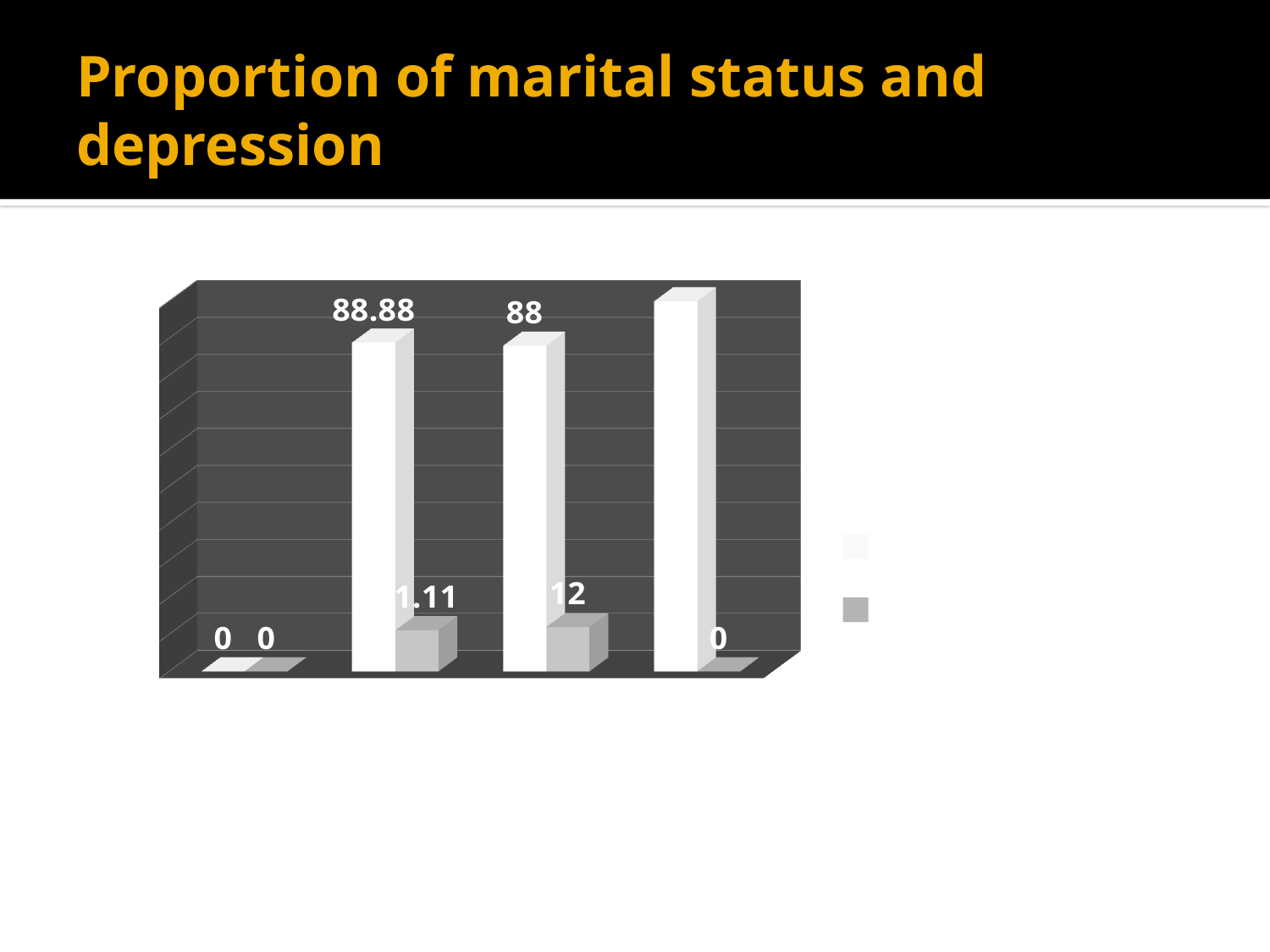
What values are labelled on the two bars in the first group from the left? 0 and 0 How many series does the chart's legend list? 2 What kind of chart is shown on the slide? bar chart What is the value labelled on the white bar in the second group from the left? 88.88 What is the value labelled on the grey bar in the third group from the left? 12 What is the value labelled on the white bar in the third group from the left? 88 In the third group from the left, which bar is larger, the white bar or the grey bar? the white bar What is the value labelled on the grey bar in the fourth group from the left? 0 Which group has the tallest white bar? the fourth group from the left What is the title of the chart on the slide? Proportion of marital status and depression What is the difference between the white bar and the grey bar in the third group from the left? 76 How many groups of bars are plotted in the chart? 4